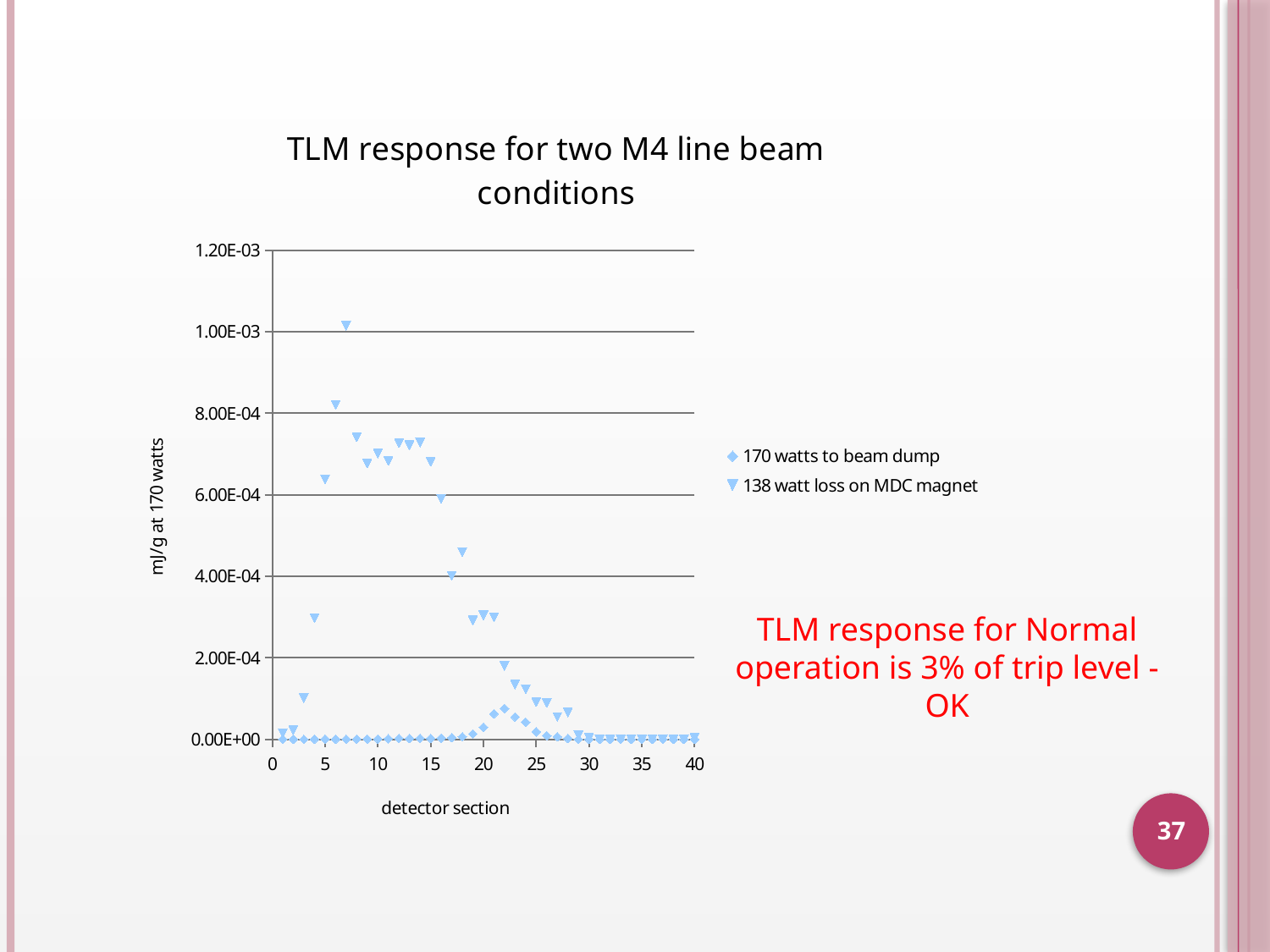
Do the values of the 138 watt loss on MDC magnet series rise or fall between detector section 15 and detector section 30? fall What is the label of the x axis? detector section At detector section 10, which series has the larger value, 170 watts to beam dump or 138 watt loss on MDC magnet? 138 watt loss on MDC magnet Is the value of the 138 watt loss on MDC magnet series at detector section 5 greater or less than 4.00E-04? greater Which series reaches the highest value on the chart? 138 watt loss on MDC magnet What is the title of the chart? TLM response for two M4 line beam conditions Is the value of the 138 watt loss on MDC magnet series at detector section 20 greater or less than 4.00E-04? less What kind of chart is shown on the slide? scatter chart Is the value of the 170 watts to beam dump series at detector section 35 greater or less than 2.00E-04? less How many series does the legend list? 2